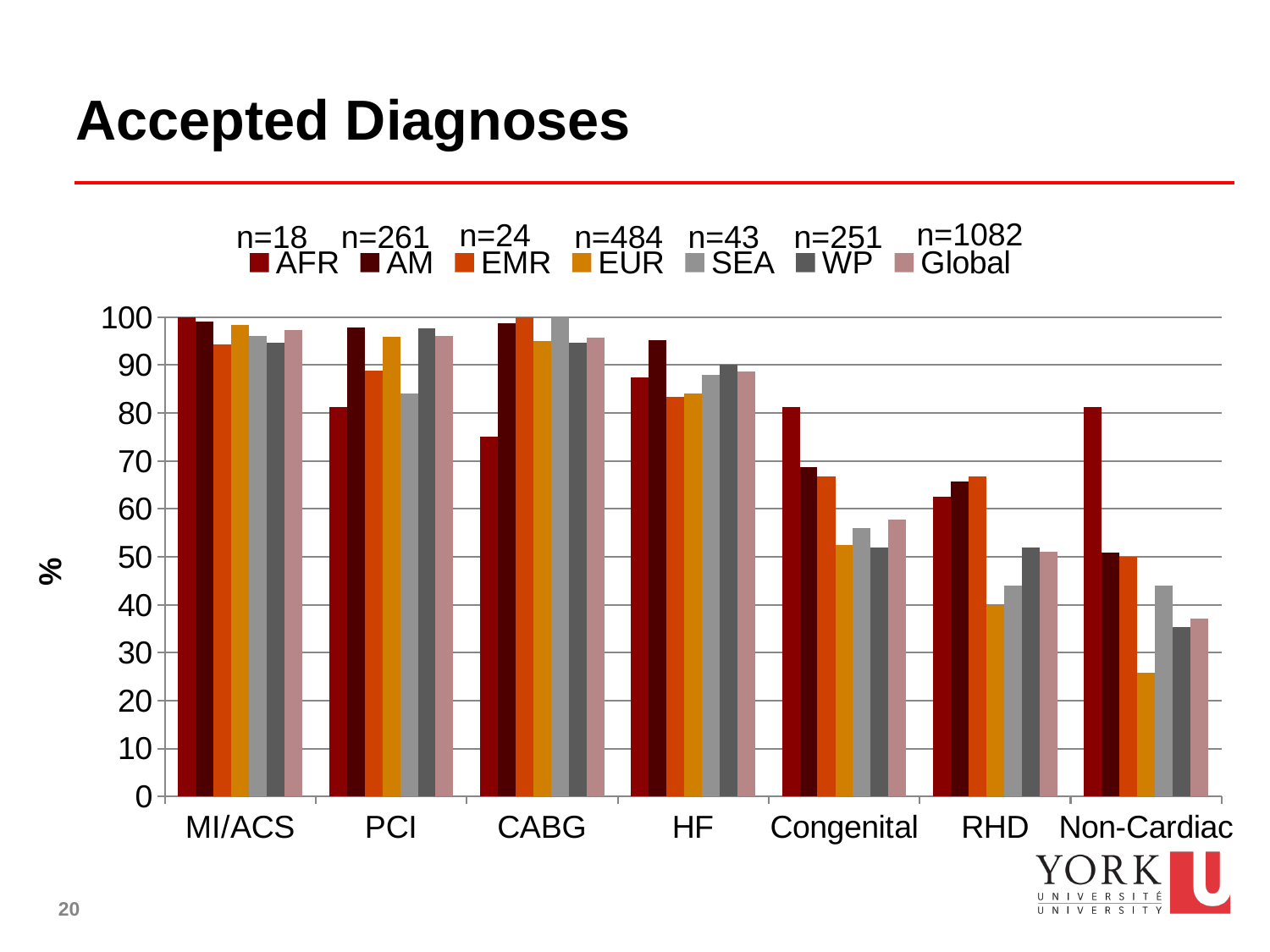
Which series has the highest value in the Congenital category? AFR Is the value for AM in the Non-Cardiac category greater or less than 70? less What kind of chart is shown on the slide? bar chart Which series has the lowest value in the CABG category? AFR Is the value for AFR in the CABG category greater or less than 80? less How many diagnosis categories are shown on the x axis? 7 In the PCI category, which is larger, the value for AFR or the value for AM? AM How many series does the legend list? 7 Do the Global values generally rise or fall moving from MI/ACS to Non-Cardiac along the x axis? fall Is the value for EUR in the Non-Cardiac category greater or less than 30? less What sample size (n) is shown above the EUR legend entry? n=484